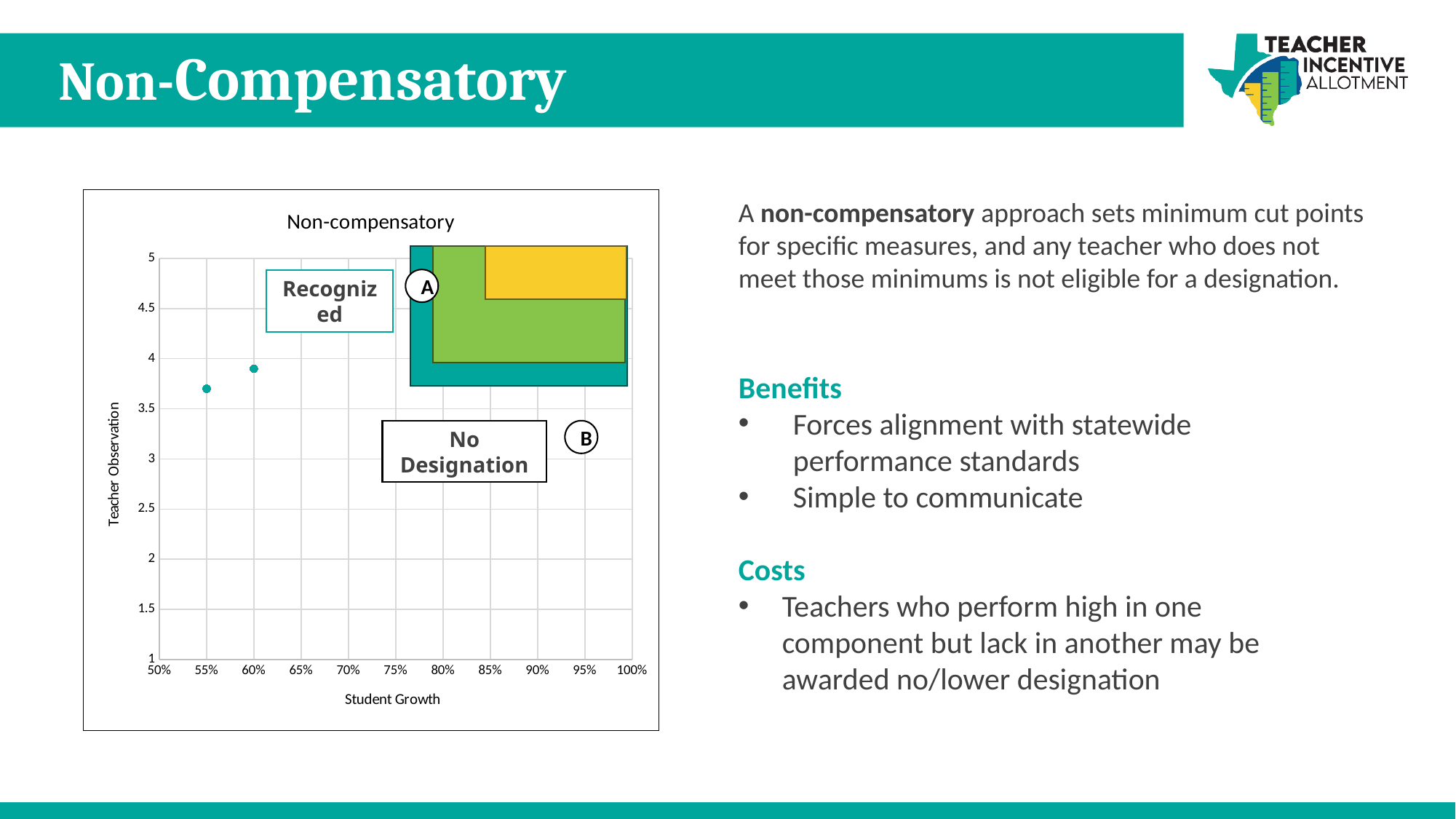
What is the title of the chart? Non-compensatory Is the Teacher Observation value for the point at 60% Student Growth greater or less than 3.5? greater Do the plotted points rise or fall in Teacher Observation as Student Growth increases? rise What kind of chart is shown on the slide? scatter chart Is the Teacher Observation value for the point at 55% Student Growth greater or less than 4? less Is the Teacher Observation value for the point at 55% Student Growth greater or less than 3.5? greater Which plotted point has the higher Teacher Observation value, the one at 55% or the one at 60% Student Growth? 60% What is the label of the x axis of the chart? Student Growth What is the Student Growth value of the leftmost plotted point? 55%